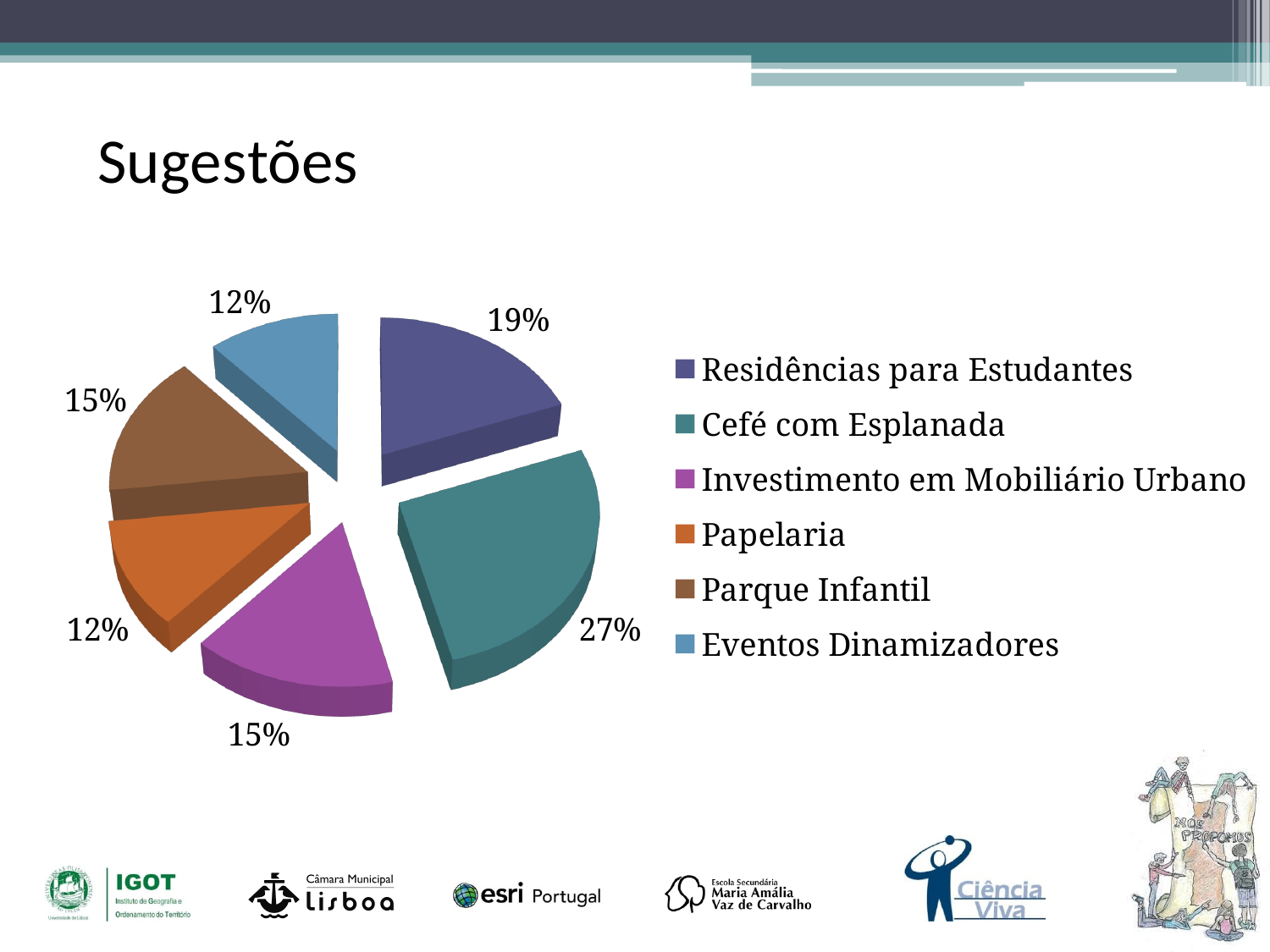
What percentage is shown for Residências para Estudantes? 19% Which legend entry is shown in orange? Papelaria What percentage is shown for Papelaria? 12% What percentage is shown for Parque Infantil? 15% Which has a larger share, Residências para Estudantes or Eventos Dinamizadores? Residências para Estudantes What percentage is shown for Investimento em Mobiliário Urbano? 15% What is the difference in percentage points between Cefé com Esplanada and Residências para Estudantes? 8 What is the title of the chart on the slide? Sugestões Which category has the largest share of the pie? Cefé com Esplanada What share of the pie does Cefé com Esplanada have? 27% What kind of chart is shown on the slide? pie chart How many categories does the pie chart have? 6